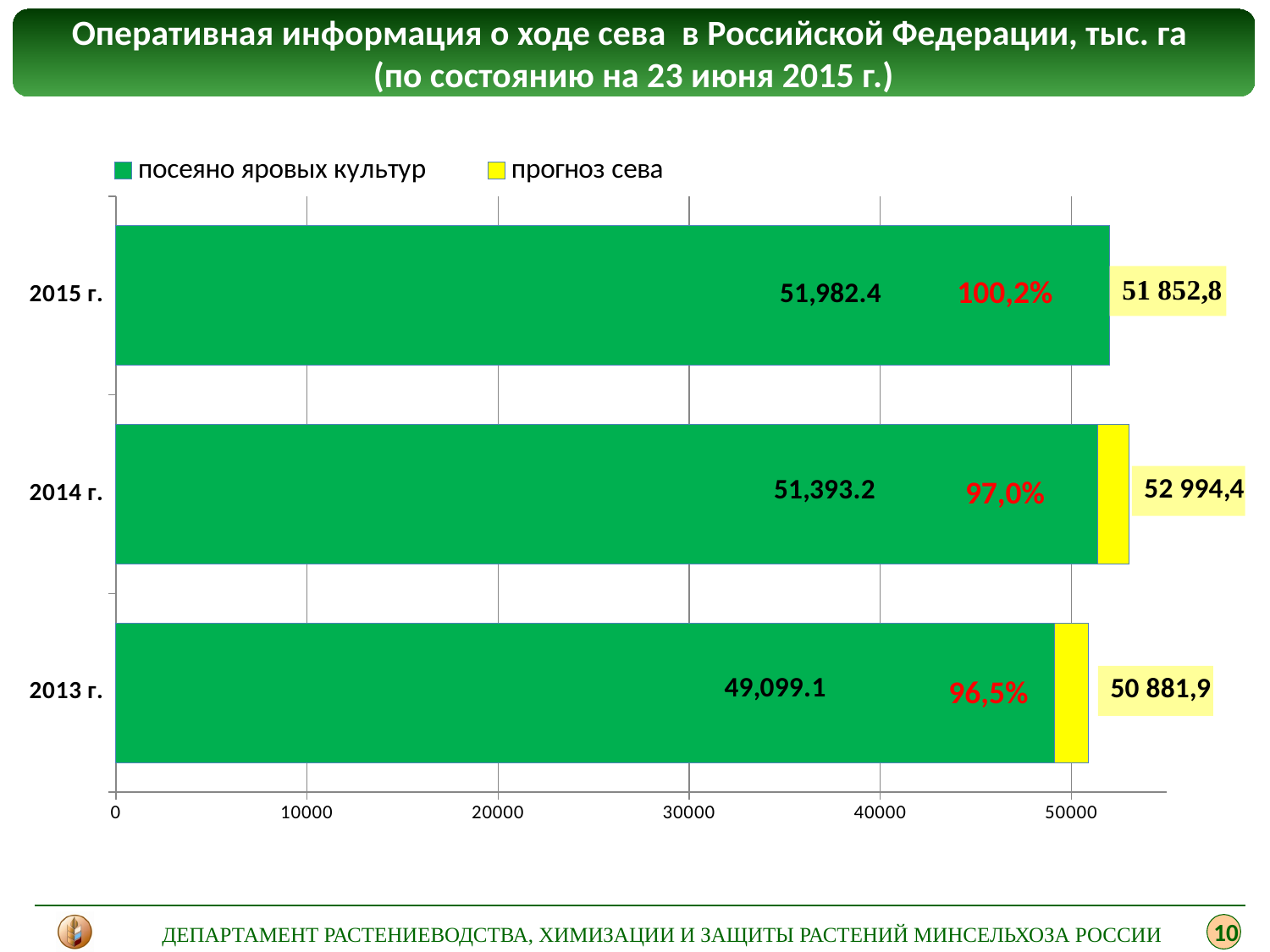
What is the value of 'посеяно яровых культур' for 2015 г.? 51,982.4 What is the value of 'посеяно яровых культур' for 2013 г.? 49,099.1 How many series does the legend list? 2 Which year has the lowest 'прогноз сева' value? 2013 г. What is the 'прогноз сева' value for 2014 г.? 52 994,4 Is the 'посеяно яровых культур' value for 2013 г. greater or less than 50000? less What percentage is shown for 2015 г.? 100,2% Which year has the highest value of 'посеяно яровых культур'? 2015 г. Which is larger: the 'прогноз сева' value for 2014 г. or for 2015 г.? 2014 г. What is the difference between the 'посеяно яровых культур' values for 2015 г. and 2013 г.? 2,883.3 What type of chart is shown on the slide? bar chart How many years (categories) are shown on the chart? 3